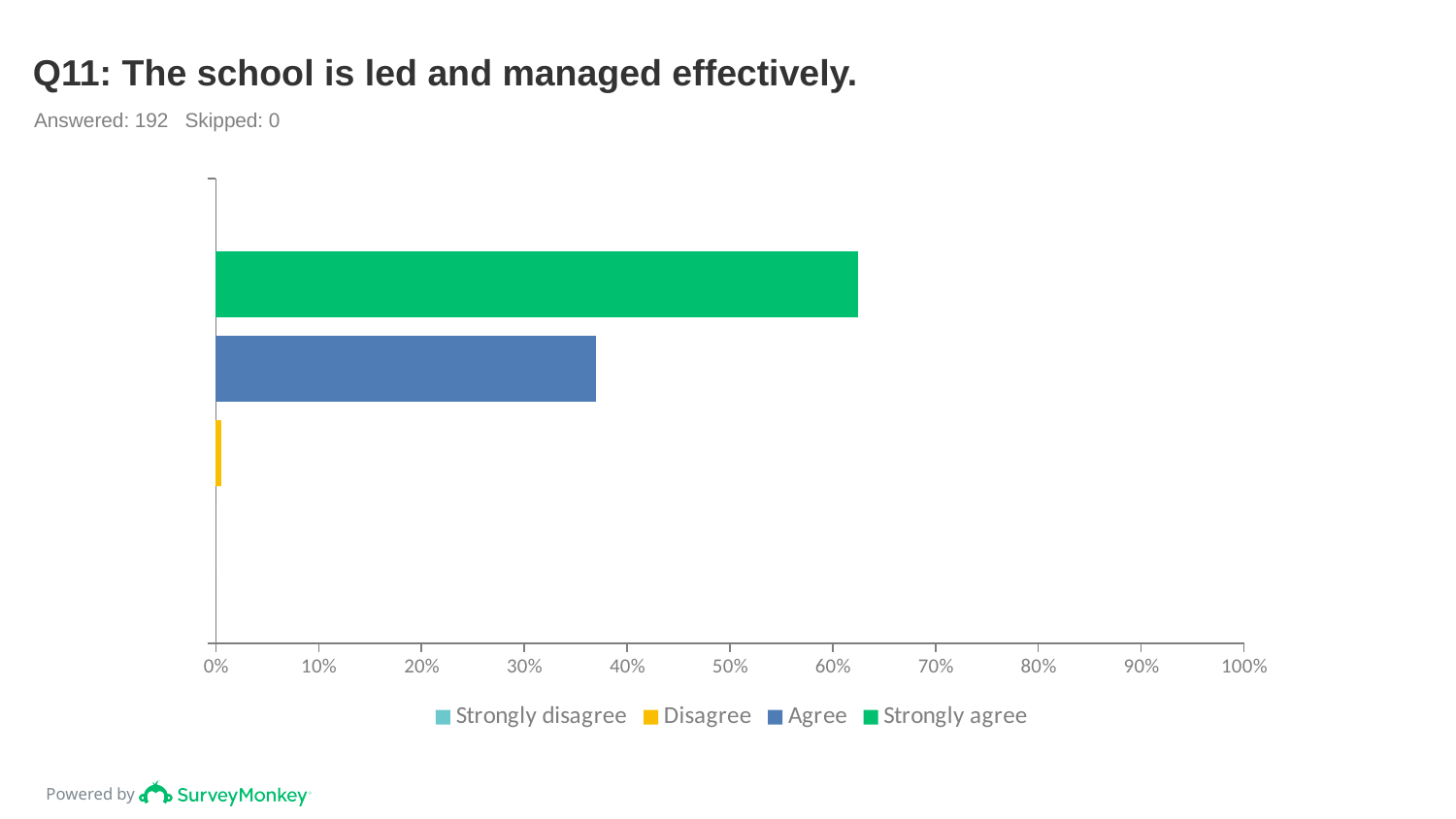
Which is larger, the value for Agree or the value for Disagree? Agree What kind of chart is shown on the slide? bar chart Which response option has the longest bar? Strongly agree How many respondents answered the question according to the slide? 192 Is the value for Strongly agree greater or less than 50%? greater What is the title of the chart? Q11: The school is led and managed effectively. Which is larger, the value for Strongly agree or the value for Agree? Strongly agree Is the value for Agree greater or less than 40%? less Is the value for Disagree greater or less than 10%? less How many series does the legend list? 4